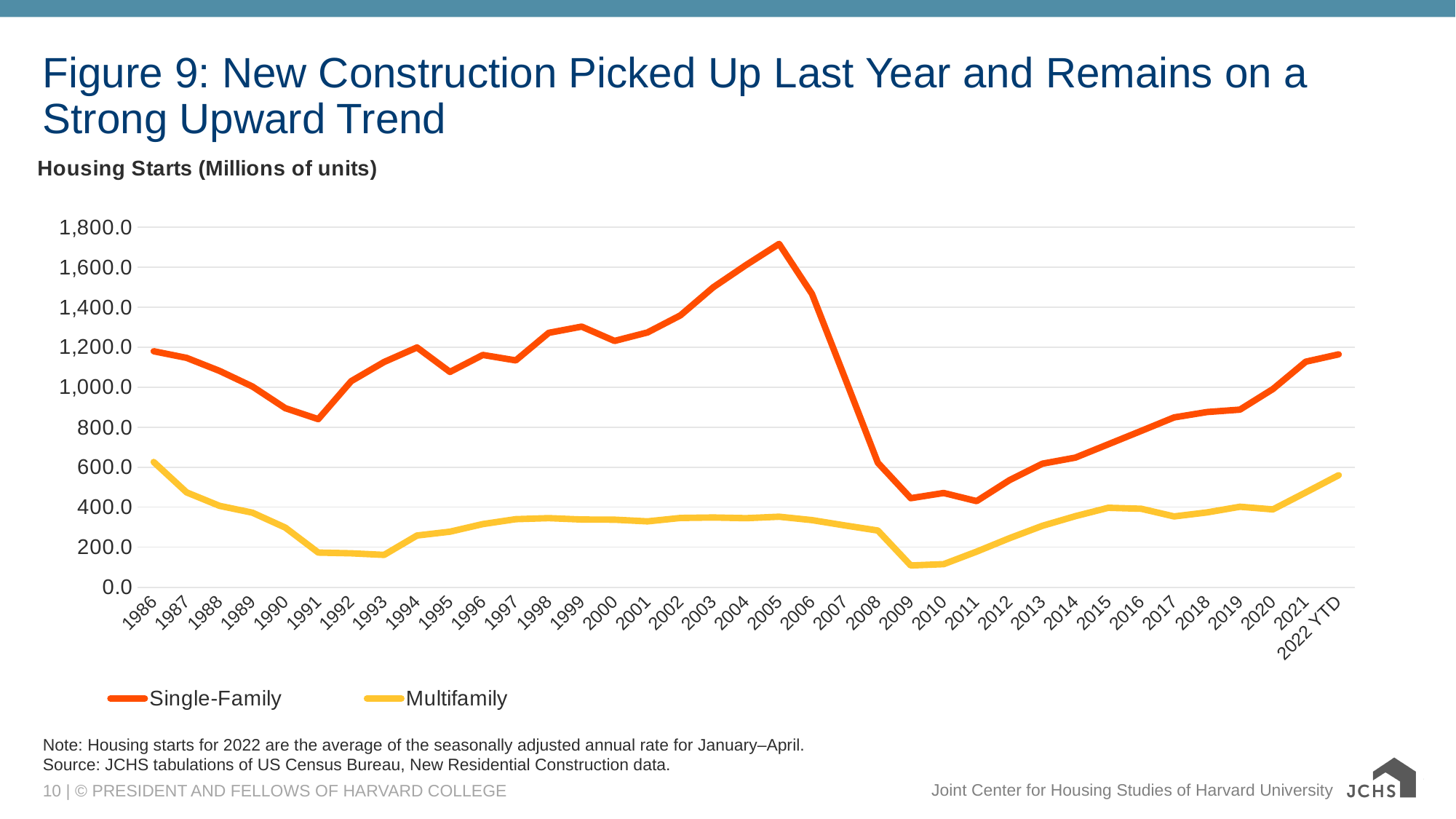
How many years (categories) are plotted along the x axis? 37 Is the Multifamily value for 2022 YTD greater or less than 400.0? greater Is the Single-Family value for 2009 greater or less than 600.0? less Does the Single-Family series rise or fall from 2011 to 2021? rise In 2005, which series has the larger value, Single-Family or Multifamily? Single-Family What kind of chart is shown on the slide? line chart How many series does the legend list? 2 In which year does the Multifamily series reach its highest value? 1986 Is the Multifamily value for 1991 greater or less than 200.0? less In which year does the Single-Family series reach its highest value? 2005 Which colour is used for the Multifamily line? yellow